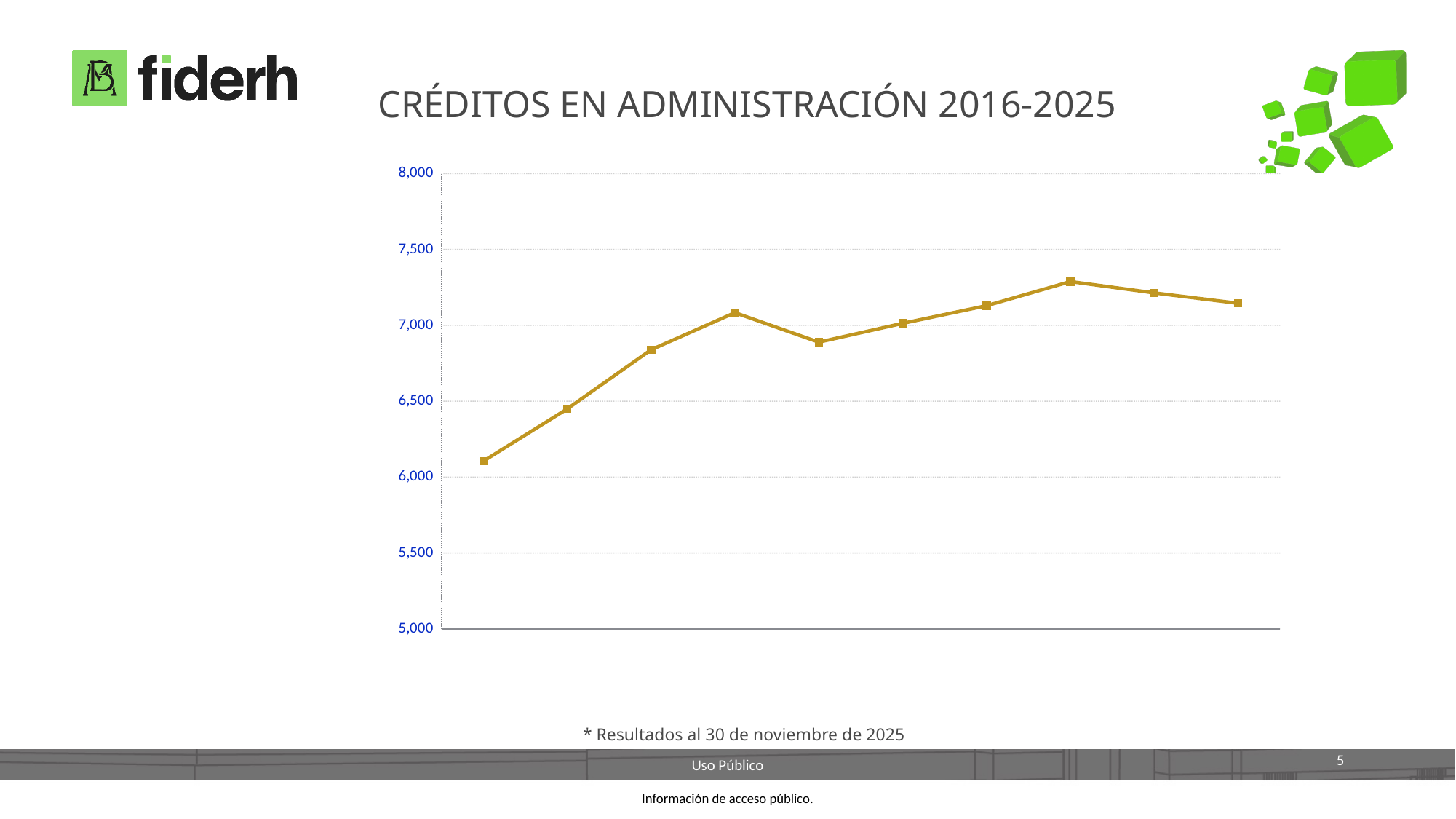
Is the value of the last (rightmost) point greater or less than 7,000? greater How many data points are plotted on the line? 10 What is the title of the chart on the slide? CRÉDITOS EN ADMINISTRACIÓN 2016-2025 What kind of chart is shown on the slide? line chart Is the value of the first (leftmost) point greater or less than 6,500? less Which point on the line has the lowest value? the first (leftmost) point Which is larger, the value of the first point or the value of the last point? the last point Is the value of the fifth point greater or less than 7,000? less Overall, do the values rise or fall from the left of the chart to the right? rise Which point on the line has the highest value? the eighth point